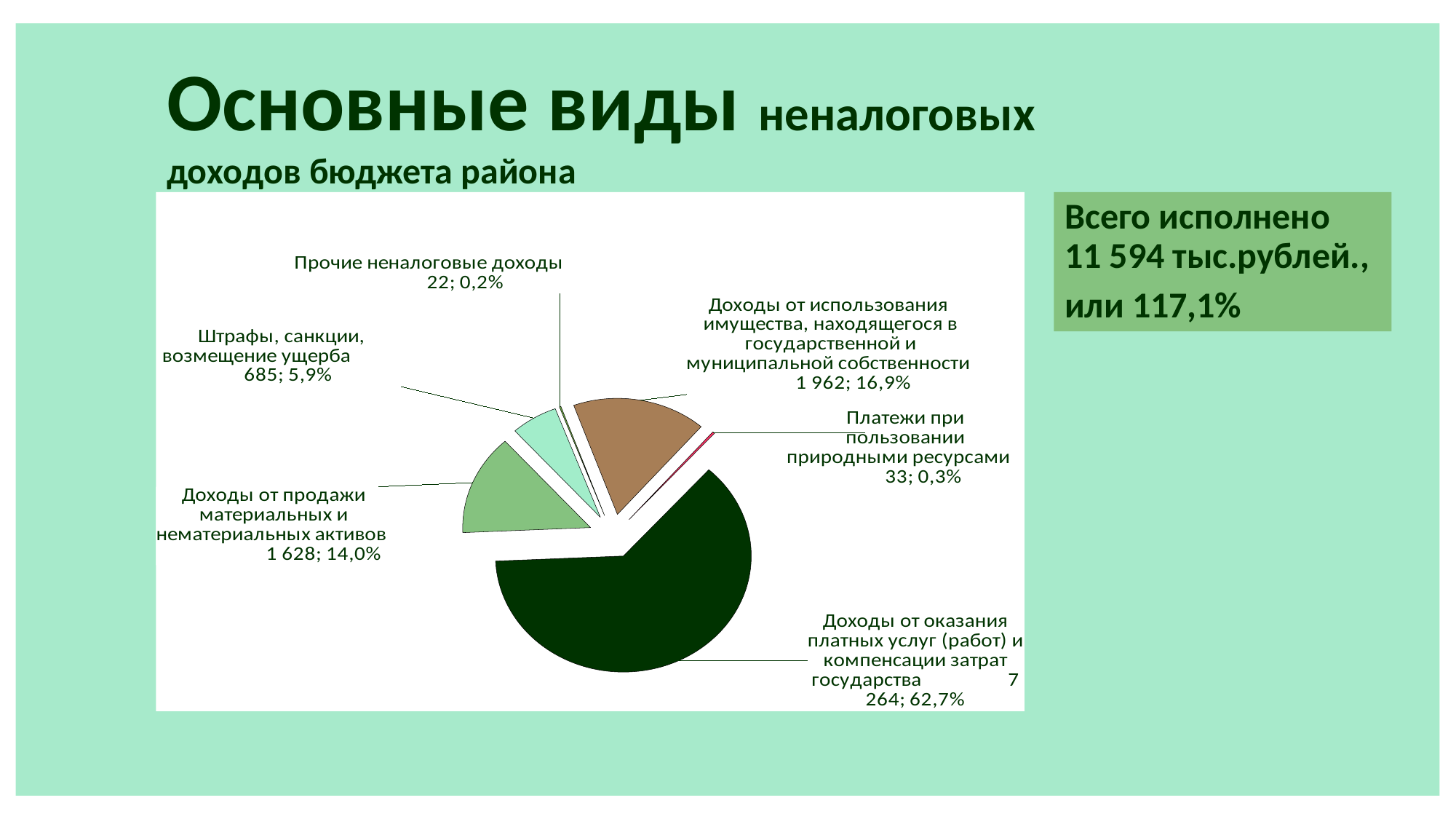
Which category has the smallest slice of the pie? Прочие неналоговые доходы What value is shown for "Платежи при пользовании природными ресурсами"? 33 Which category has the largest slice of the pie? Доходы от оказания платных услуг (работ) и компенсации затрат государства What is the difference between the values for "Доходы от использования имущества, находящегося в государственной и муниципальной собственности" and "Доходы от продажи материальных и нематериальных активов"? 334 How many slices does the pie chart have? 6 What value is shown for "Штрафы, санкции, возмещение ущерба"? 685 Which is larger: "Доходы от продажи материальных и нематериальных активов" or "Доходы от использования имущества, находящегося в государственной и муниципальной собственности"? Доходы от использования имущества, находящегося в государственной и муниципальной собственности What value is shown for "Доходы от оказания платных услуг (работ) и компенсации затрат государства"? 7 264 What share of the pie does "Прочие неналоговые доходы" have? 0,2% What share of the pie does "Доходы от использования имущества, находящегося в государственной и муниципальной собственности" have? 16,9% What colour is the largest slice of the pie chart? dark green What kind of chart is shown on the slide? pie chart